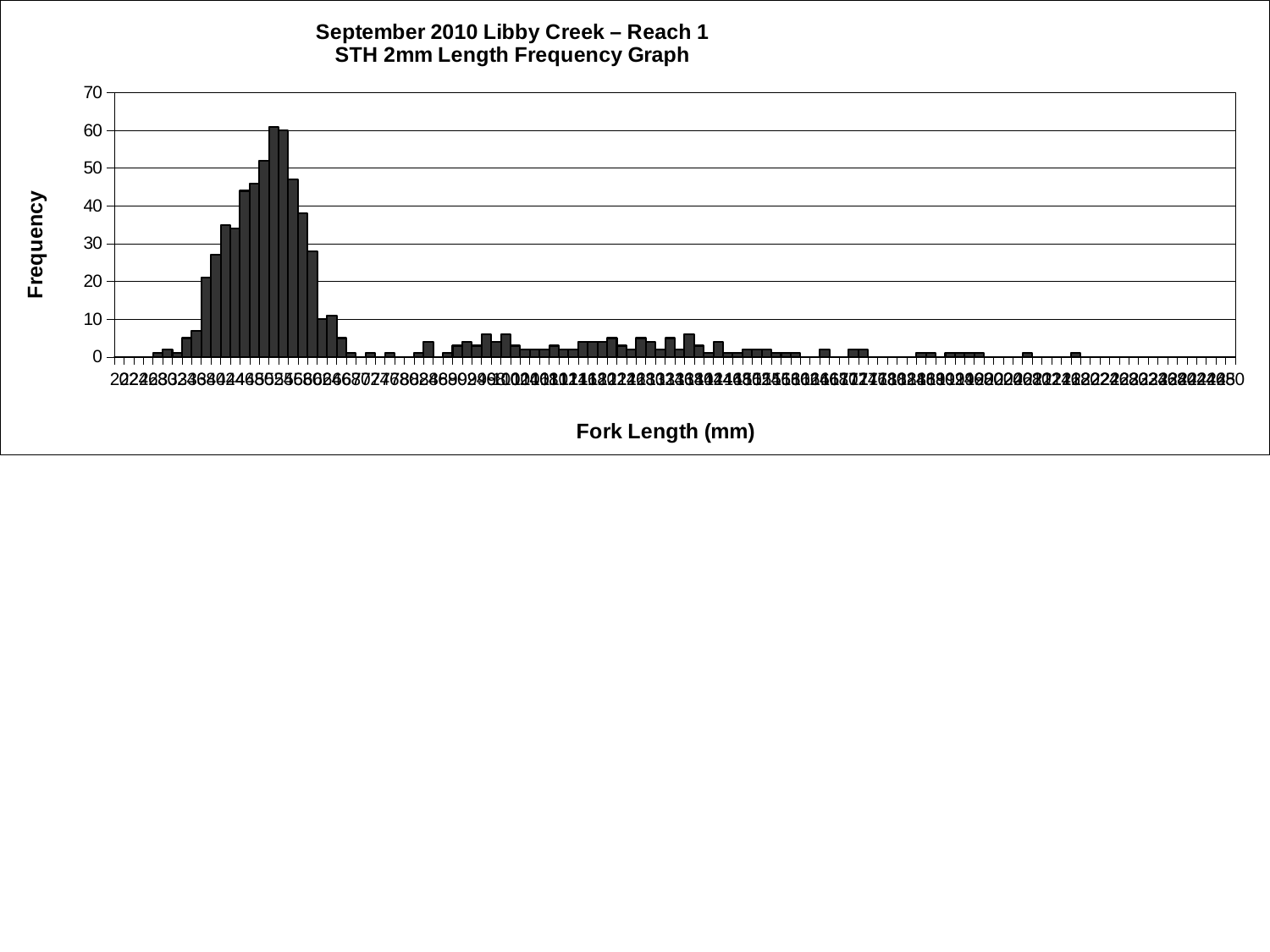
What is the label on the x axis of the chart? Fork Length (mm) Are the bars to the right of the main peak greater or less than 20? less What is the title of the chart? September 2010 Libby Creek – Reach 1 STH 2mm Length Frequency Graph Is the value of the tallest bar greater or less than 50? greater Is the value of the tallest bar greater or less than 40? greater What kind of chart is shown on the slide? bar chart